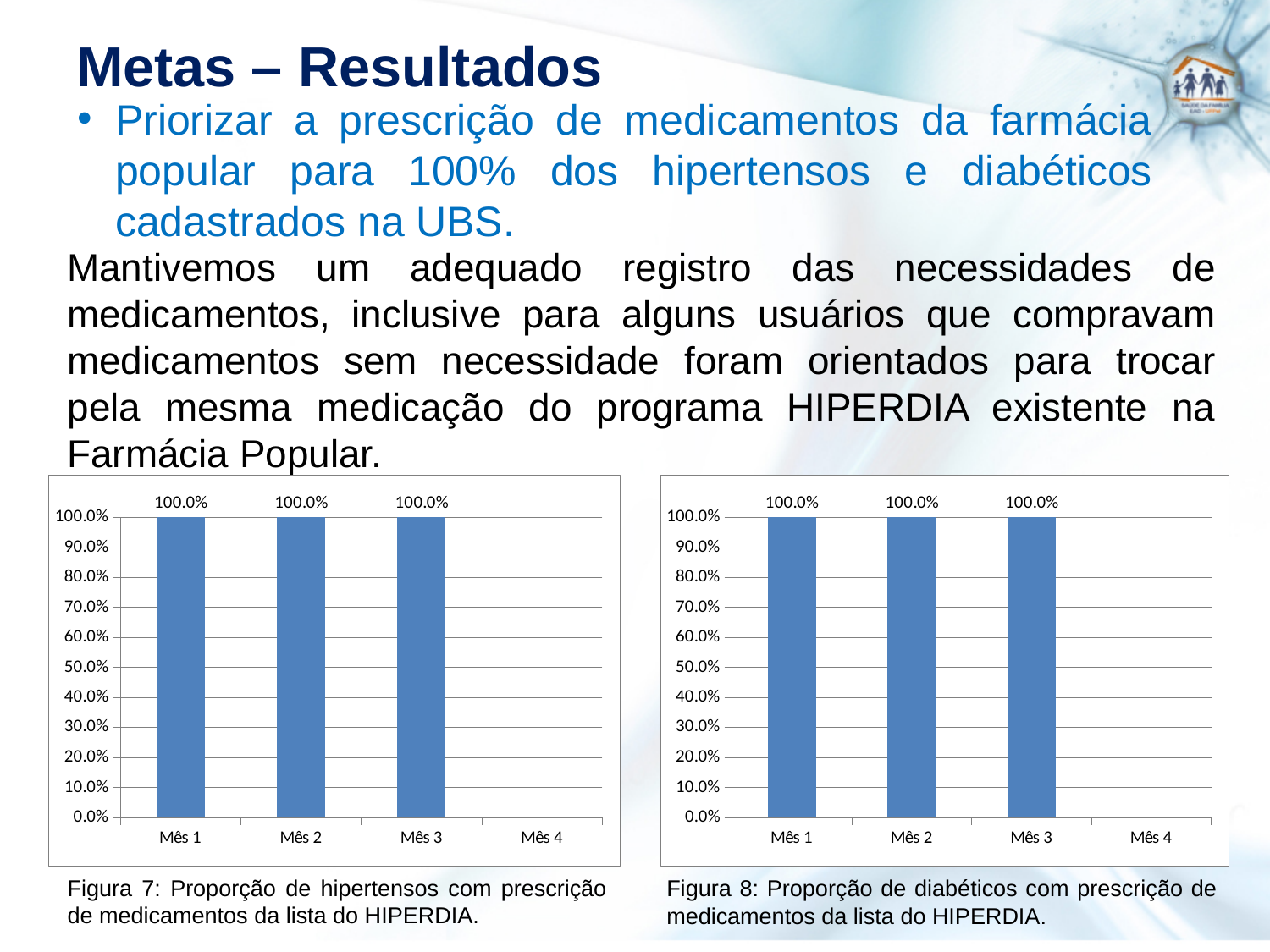
In the left chart (Figura 7), do the values rise, fall or stay the same from Mês 1 to Mês 3? stay the same In the left chart (Figura 7), how many bars are plotted? 3 In the right chart (Figura 8), which month category has no bar plotted? Mês 4 In the left chart (Figura 7), what is the value for Mês 3? 100.0% In the right chart (Figura 8), what is the value for Mês 2? 100.0% In the left chart (Figura 7), what is the difference between the values for Mês 1 and Mês 2? 0.0% What kind of chart is the left chart (Figura 7)? bar chart According to its caption, what does the left chart (Figura 7) show? Proporção de hipertensos com prescrição de medicamentos da lista do HIPERDIA In the left chart (Figura 7), what is the value for Mês 1? 100.0% How many month categories are labelled on the x axis of the right chart (Figura 8)? 4 In the right chart (Figura 8), is the value for Mês 1 greater or less than 90.0%? greater In the right chart (Figura 8), what is the value for Mês 3? 100.0%